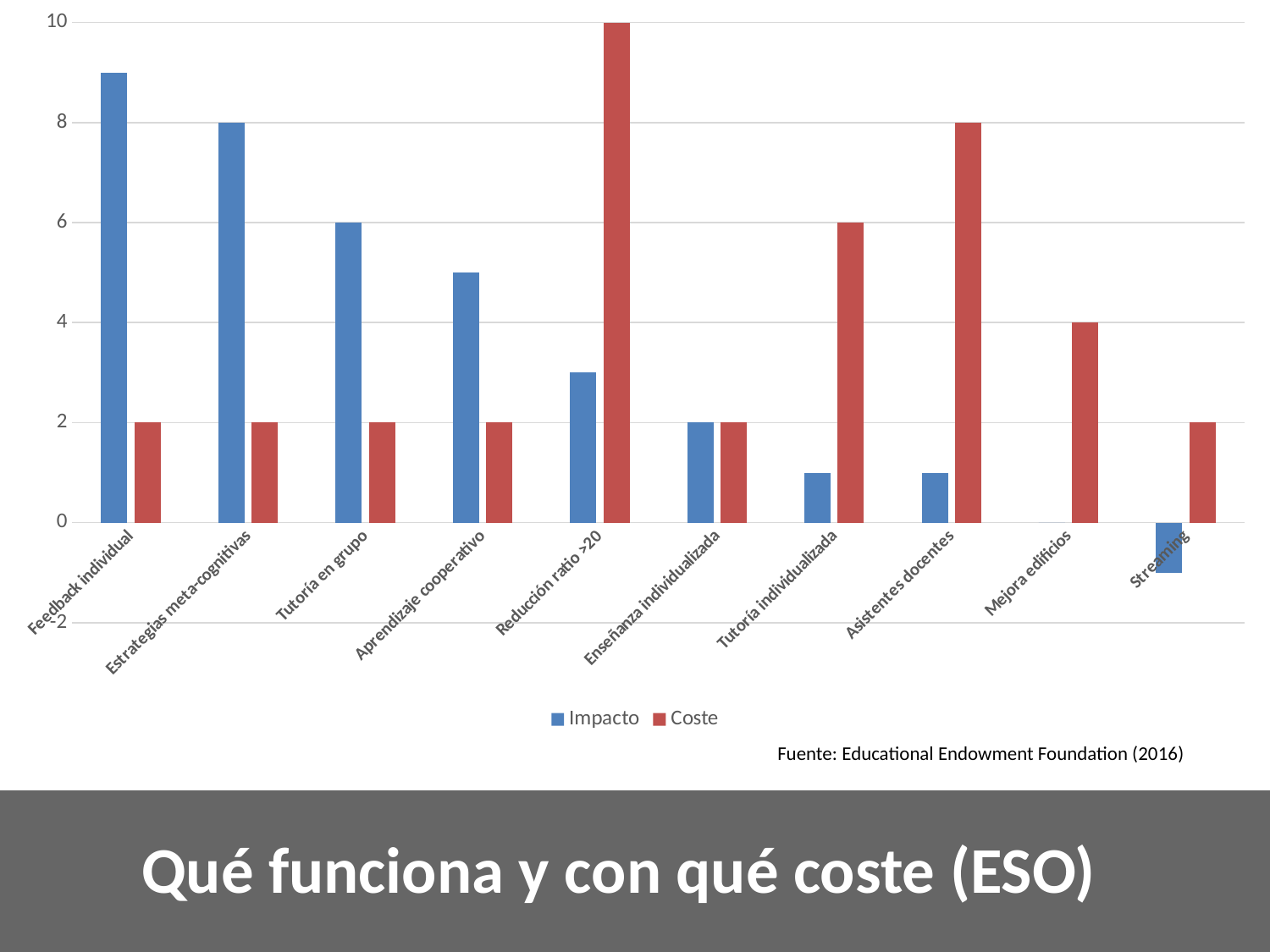
How many series does the legend list? 2 Which category has the highest Impacto value? Feedback individual For Tutoría en grupo, which is larger, Impacto or Coste? Impacto What is the Coste value for Mejora edificios? 4 Which category has the highest Coste value? Reducción ratio >20 Is the Impacto value for Feedback individual greater or less than 8? greater What is the Impacto value for Estrategias meta-cognitivas? 8 Which category has the lowest Impacto value? Streaming What is the Coste value for Asistentes docentes? 8 How many categories are shown on the x axis? 10 What is the difference between the Coste values for Asistentes docentes and Tutoría individualizada? 2 What is the Coste value for Reducción ratio >20? 10